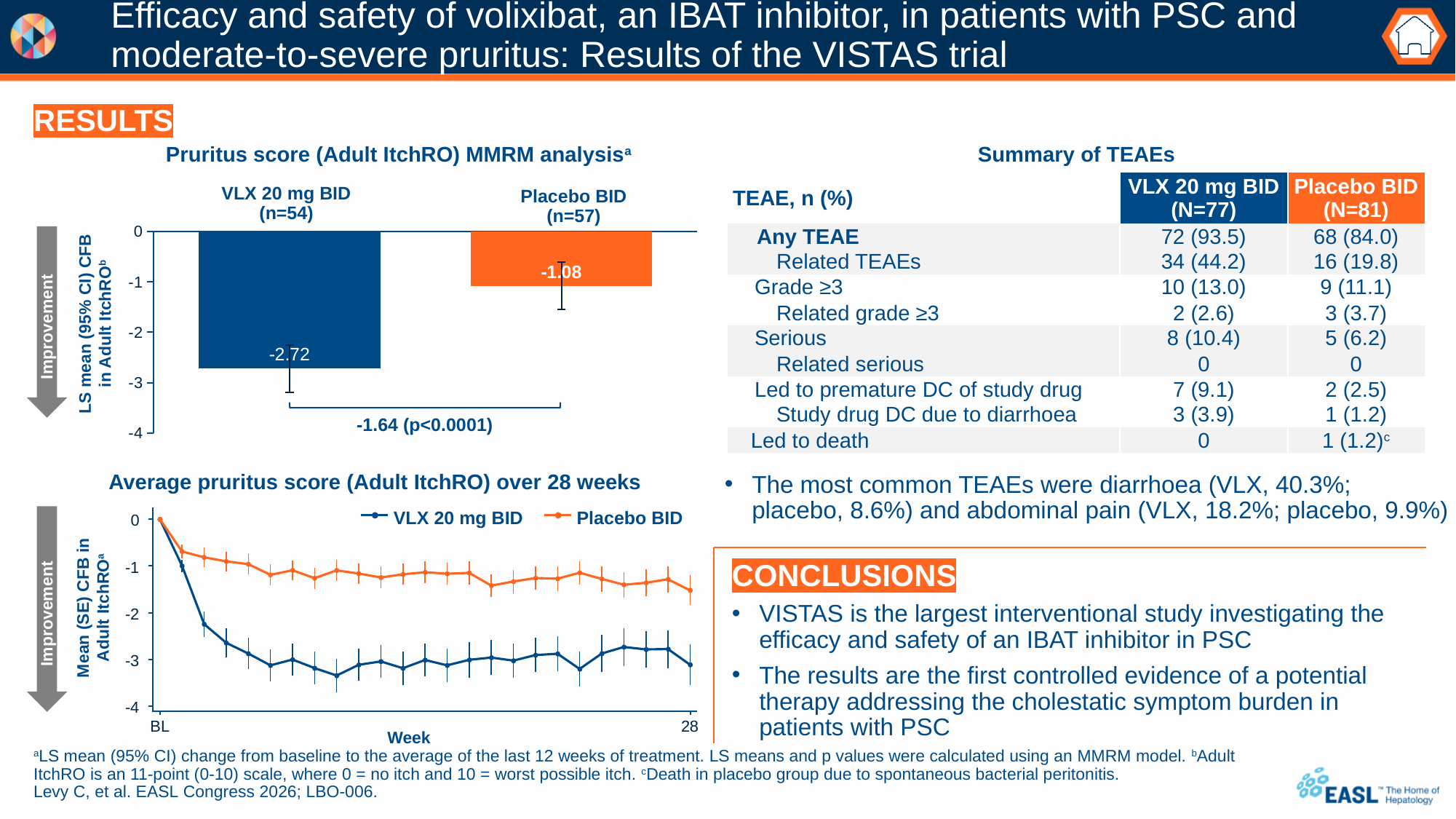
In the 'Pruritus score (Adult ItchRO) MMRM analysis' chart, is the value for VLX 20 mg BID greater or less than -2? less What kind of chart is the 'Pruritus score (Adult ItchRO) MMRM analysis' chart? Bar chart In the 'Pruritus score (Adult ItchRO) MMRM analysis' chart, which group shows the larger reduction from baseline? VLX 20 mg BID In the 'Pruritus score (Adult ItchRO) MMRM analysis' chart, what is the difference between the VLX 20 mg BID and Placebo BID values shown on the slide? -1.64 (p<0.0001) In the 'Average pruritus score (Adult ItchRO) over 28 weeks' chart, do the values for VLX 20 mg BID rise or fall from baseline over the first weeks? Fall In the 'Average pruritus score (Adult ItchRO) over 28 weeks' chart, at week 28 which series has the lower value, VLX 20 mg BID or Placebo BID? VLX 20 mg BID In the 'Average pruritus score (Adult ItchRO) over 28 weeks' chart, is the Placebo BID value at week 28 greater or less than -1? less In the 'Pruritus score (Adult ItchRO) MMRM analysis' chart, what is the LS mean change from baseline for Placebo BID? -1.08 What kind of chart is the 'Average pruritus score (Adult ItchRO) over 28 weeks' chart? Line chart In the 'Pruritus score (Adult ItchRO) MMRM analysis' chart, how many bars are plotted? 2 In the 'Average pruritus score (Adult ItchRO) over 28 weeks' chart, how many series does the legend list? 2 In the 'Pruritus score (Adult ItchRO) MMRM analysis' chart, what is the LS mean change from baseline for VLX 20 mg BID? -2.72